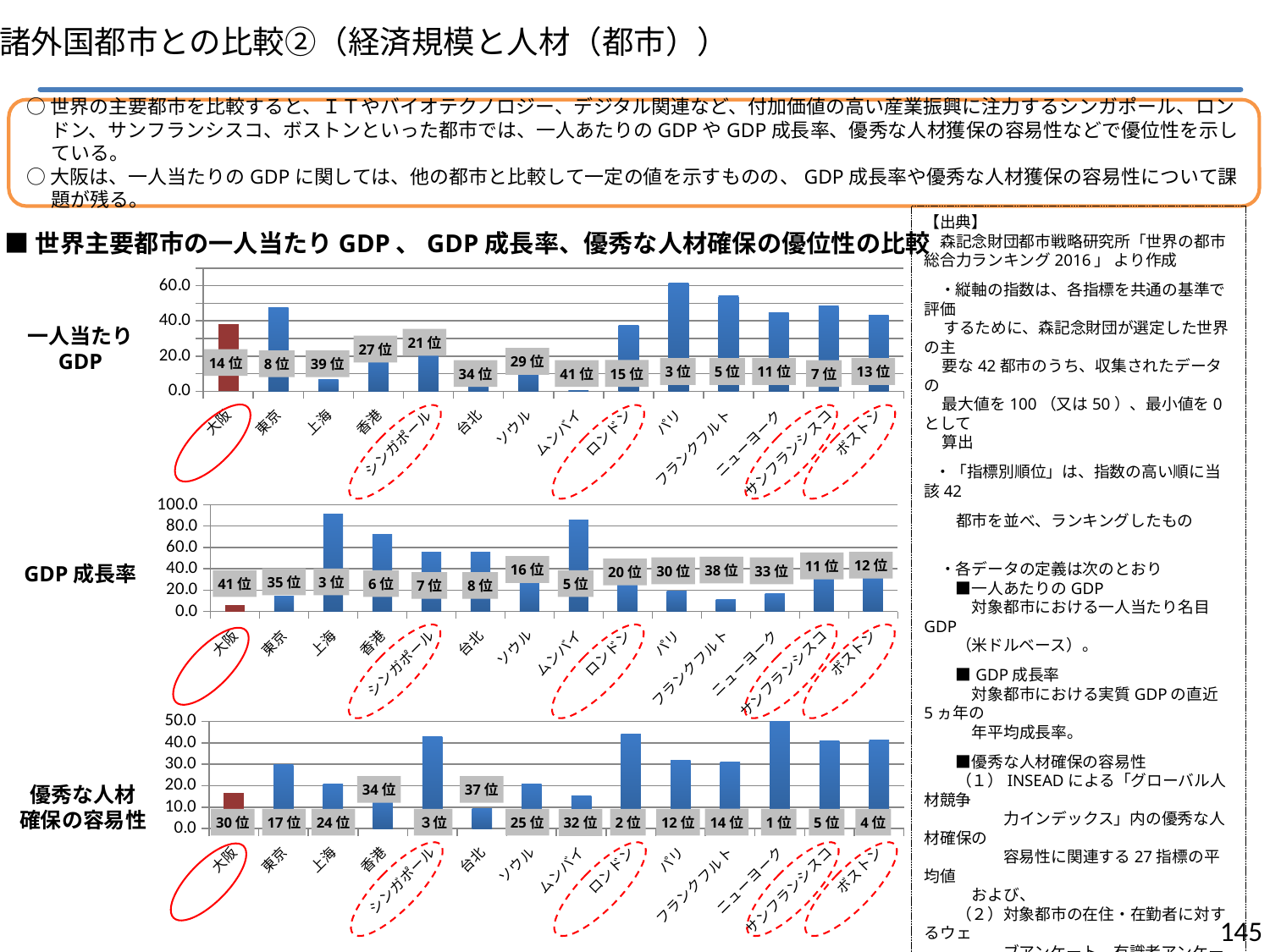
In the 一人当たりGDP chart, is the value for パリ greater or less than 40.0? greater In the 優秀な人材確保の容易性 chart, which has the larger value, シンガポール or 東京? シンガポール In the 一人当たりGDP chart, which city has the highest bar? パリ In the 優秀な人材確保の容易性 chart, which city has the highest bar? ニューヨーク In the 優秀な人材確保の容易性 chart, what rank label is shown for ロンドン? 2位 What kind of chart is the 一人当たりGDP chart? bar chart In the GDP成長率 chart, how many cities are plotted? 14 In the GDP成長率 chart, which city has the lowest bar? 大阪 In the GDP成長率 chart, is the value for 大阪 greater or less than 20.0? less In the GDP成長率 chart, what rank label is shown for ムンバイ? 5位 In the GDP成長率 chart, which city has the highest bar? 上海 In the 一人当たりGDP chart, what rank label is shown for 大阪? 14位